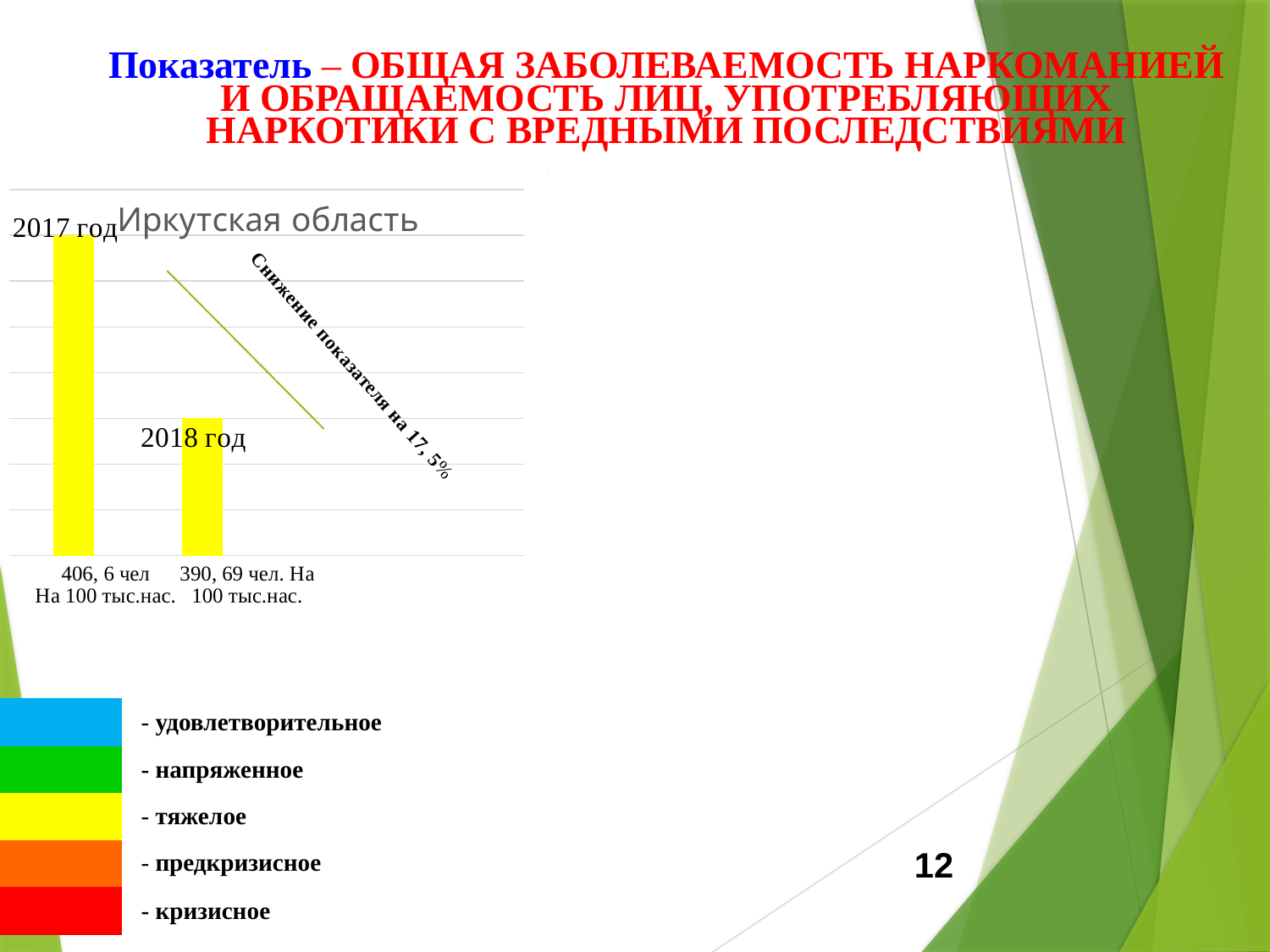
Which year has the taller bar in the chart? 2017 год What is the title of the chart on the slide? Иркутская область What colour are the bars in the chart? yellow How many bars does the chart show? 2 Which year has the shorter bar in the chart? 2018 год What type of chart is shown on the slide? bar chart Do the values rise or fall from 2017 год to 2018 год? fall What value is printed under the bar for 2017 год? 406, 6 чел на 100 тыс.нас. According to the colour key at the bottom of the slide, what condition does the yellow colour of the bars correspond to? тяжелое Is the value for 2017 год larger or smaller than the value for 2018 год? larger What value is printed under the bar for 2018 год? 390, 69 чел. на 100 тыс.нас. By what percentage does the annotation say the indicator decreased? 17, 5%